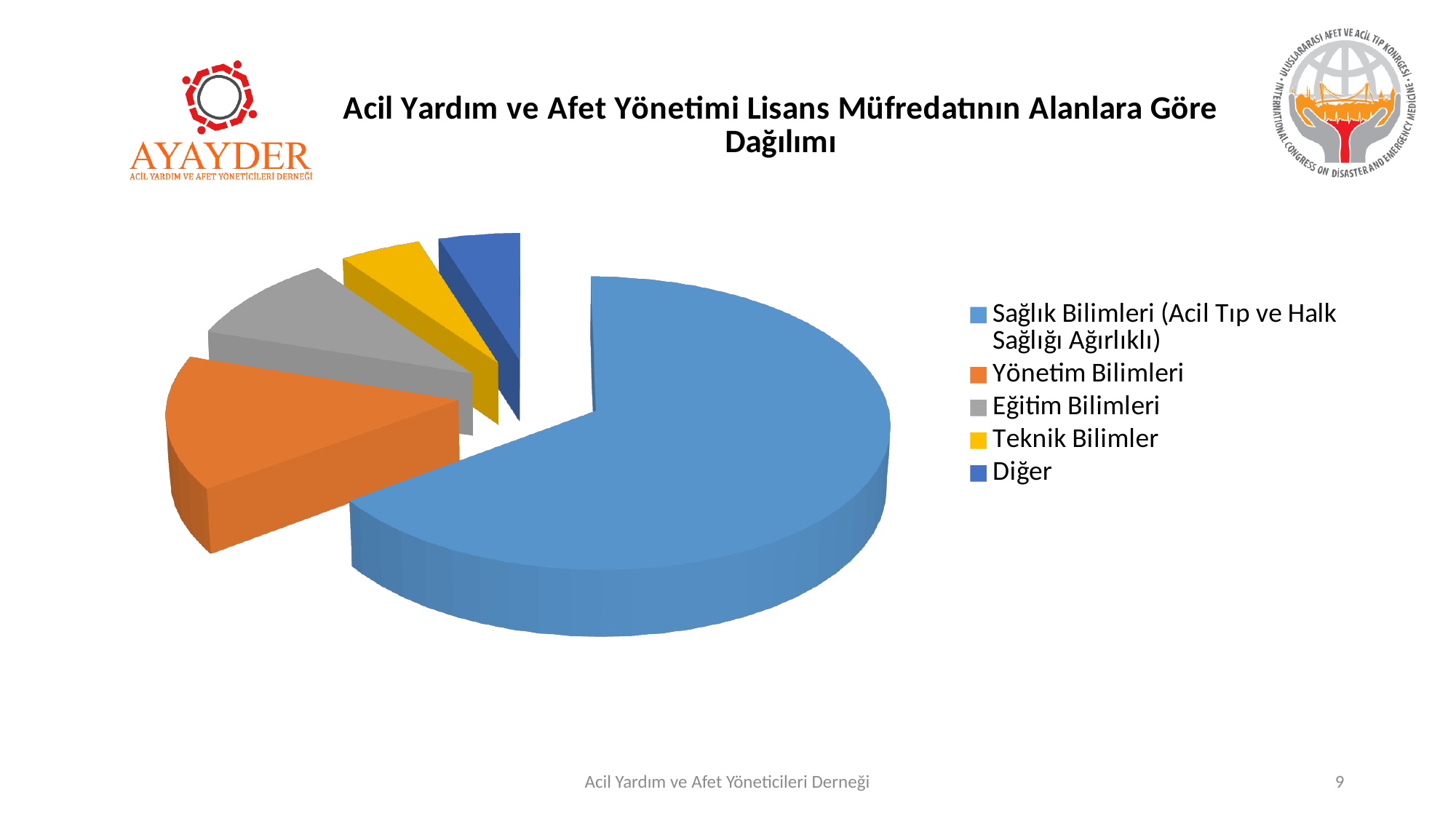
Which colour represents Teknik Bilimler in the pie chart? yellow How many categories does the pie chart show? 5 Which slice is larger, Eğitim Bilimleri or Diğer? Eğitim Bilimleri What is the title of the chart on the slide? Acil Yardım ve Afet Yönetimi Lisans Müfredatının Alanlara Göre Dağılımı Which slice is larger, Sağlık Bilimleri (Acil Tıp ve Halk Sağlığı Ağırlıklı) or Yönetim Bilimleri? Sağlık Bilimleri (Acil Tıp ve Halk Sağlığı Ağırlıklı) Which category has the largest slice of the pie chart? Sağlık Bilimleri (Acil Tıp ve Halk Sağlığı Ağırlıklı) Which slice is larger, Yönetim Bilimleri or Eğitim Bilimleri? Yönetim Bilimleri What kind of chart is shown on the slide? pie chart Which category is the second largest slice of the pie chart? Yönetim Bilimleri